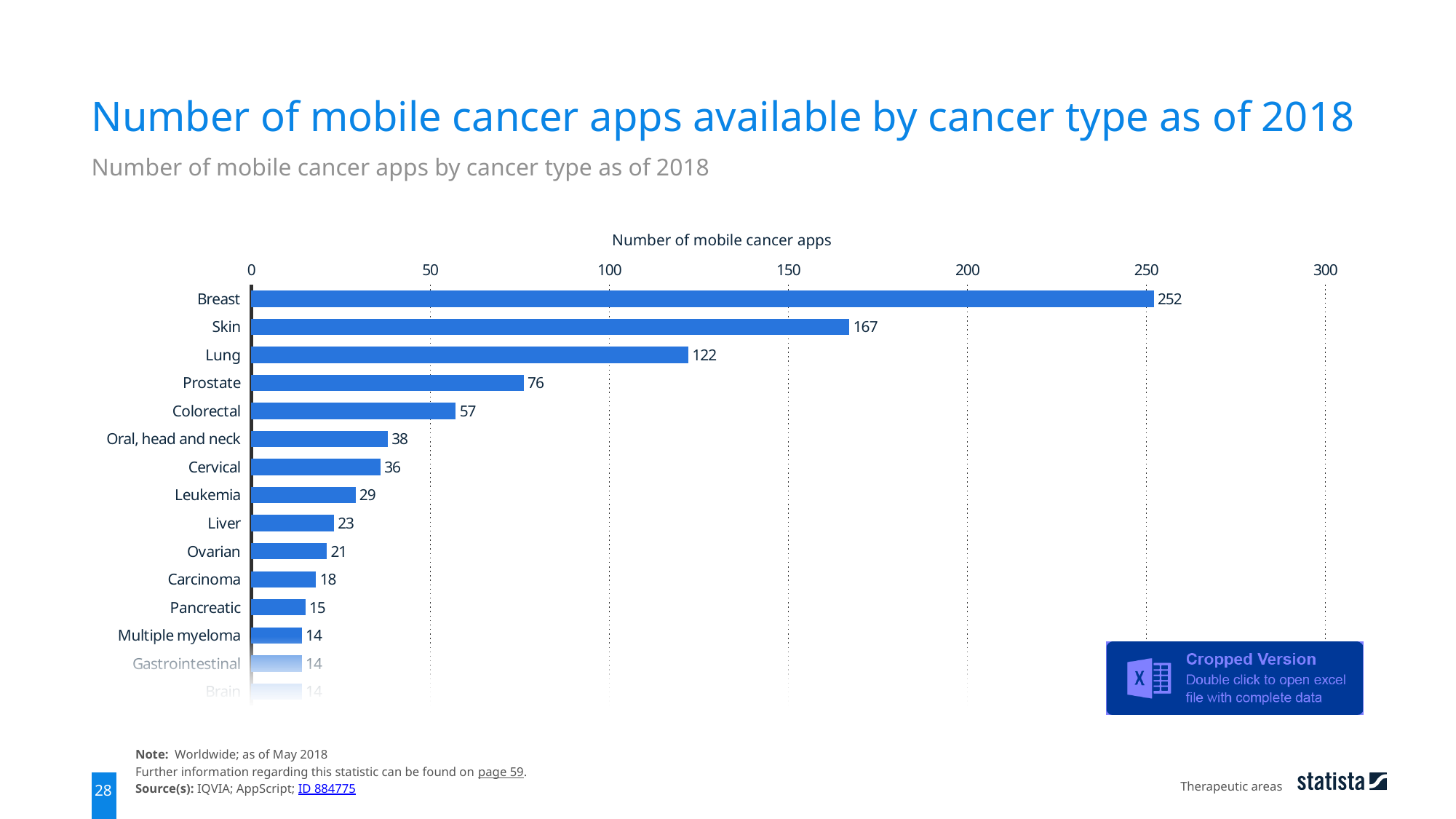
What kind of chart is shown on the slide? Bar chart What is the number of mobile cancer apps for lung cancer? 122 What is the difference between the number of apps for breast cancer and skin cancer? 85 What is the label of the horizontal axis of the chart? Number of mobile cancer apps What is the difference between the number of apps for prostate cancer and colorectal cancer? 19 What is the value shown for leukemia? 29 How many mobile cancer apps are there for colorectal cancer? 57 Which cancer type has the highest number of mobile cancer apps? Breast How many mobile cancer apps are available for breast cancer? 252 Is the value for skin cancer greater or less than 150? greater Which has more mobile cancer apps, cervical cancer or oral, head and neck cancer? Oral, head and neck Which has more mobile cancer apps, liver cancer or ovarian cancer? Liver